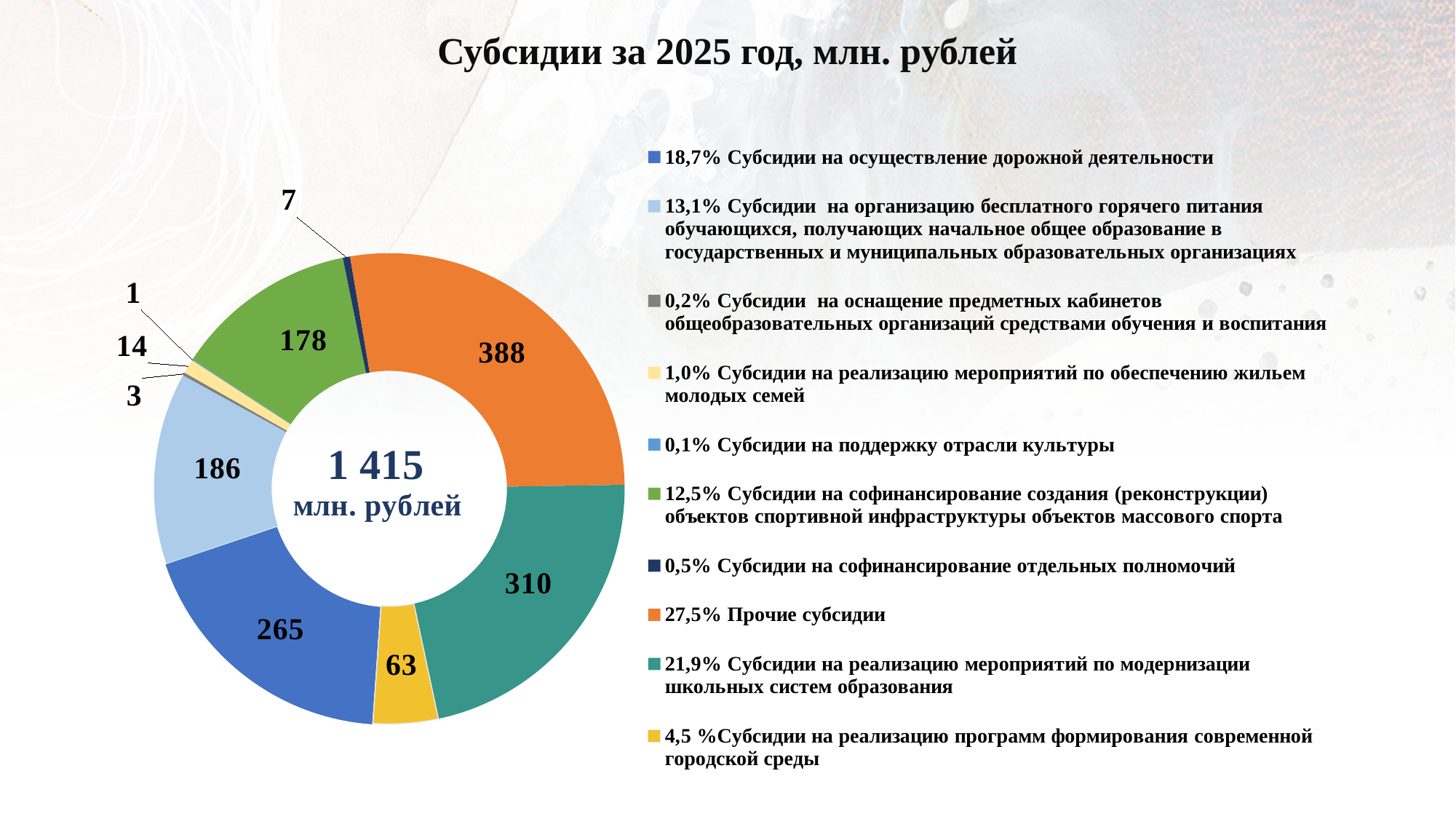
What type of chart is shown on the slide? Doughnut (pie) chart What total is shown in the centre of the doughnut chart? 1 415 млн. рублей How many categories does the legend list? 10 Which category has the largest value? Прочие субсидии What is the value for "Субсидии на реализацию мероприятий по модернизации школьных систем образования"? 310 What is the value for "Субсидии на осуществление дорожной деятельности"? 265 Which is larger: the value for "Субсидии на организацию бесплатного горячего питания..." or for "Субсидии на софинансирование создания (реконструкции) объектов спортивной инфраструктуры..."? Субсидии на организацию бесплатного горячего питания (186) What is the value for "Субсидии на реализацию программ формирования современной городской среды"? 63 Which category has the smallest value? Субсидии на поддержку отрасли культуры What is the difference between the values for "Прочие субсидии" and "Субсидии на осуществление дорожной деятельности"? 123 What share of the total do "Прочие субсидии" represent according to the legend? 27,5% What is the value for "Прочие субсидии"? 388